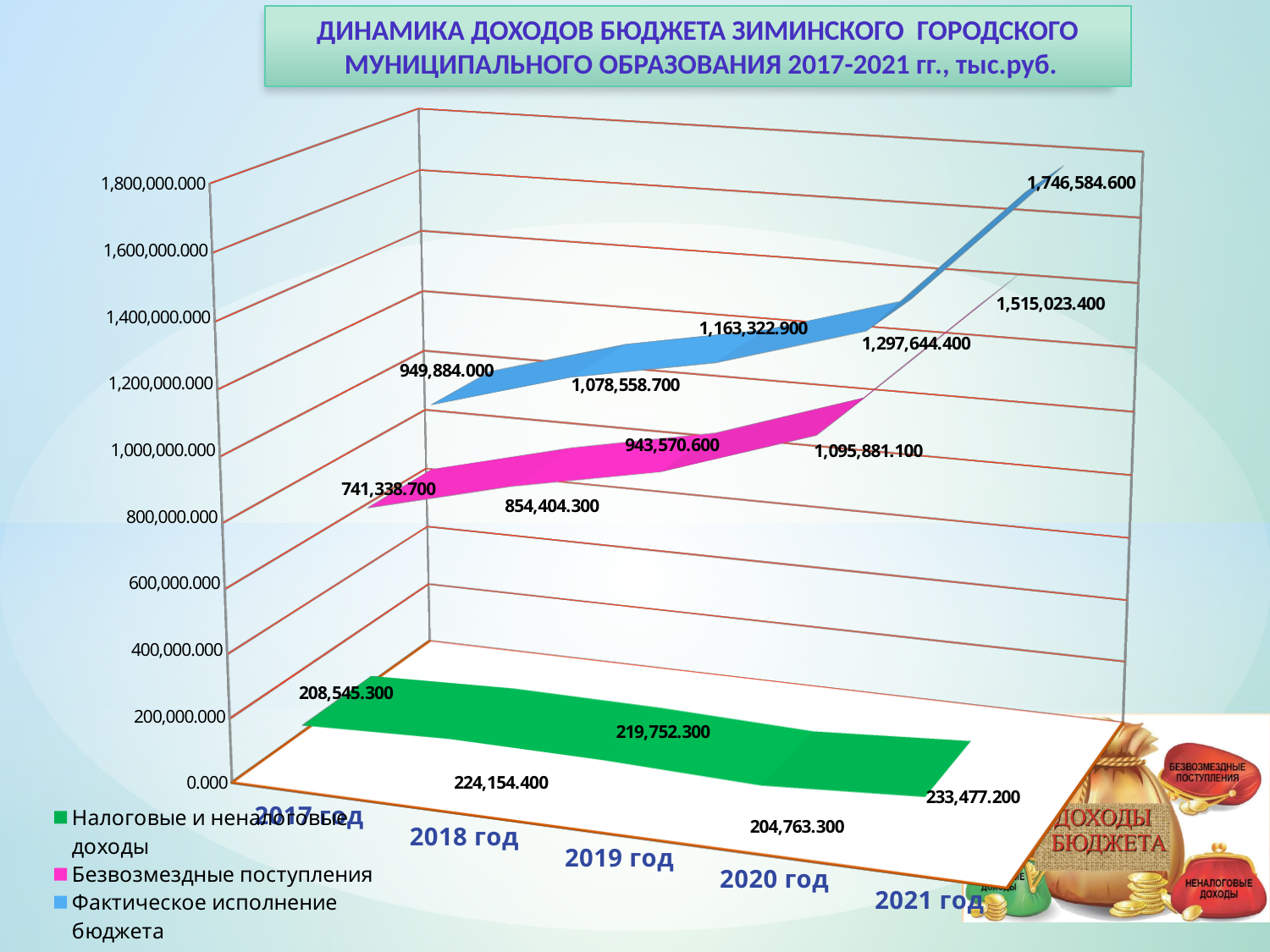
What is the value of Безвозмездные поступления for 2019 год? 943,570.600 How many series does the legend list? 3 In which year is Безвозмездные поступления the highest? 2021 год In which year is Налоговые и неналоговые доходы the lowest? 2020 год What is the value of Налоговые и неналоговые доходы for 2018 год? 224,154.400 Does Фактическое исполнение бюджета rise or fall from 2017 год to 2021 год? Rise What is the difference between Фактическое исполнение бюджета in 2021 год and 2020 год? 448,940.200 What kind of chart is shown on the slide? 3D line chart Which is larger: Безвозмездные поступления in 2020 год or in 2018 год? 2020 год What is the value of Фактическое исполнение бюджета for 2021 год? 1,746,584.600 How many years are shown on the x axis? 5 What is the value of Фактическое исполнение бюджета for 2017 год? 949,884.000